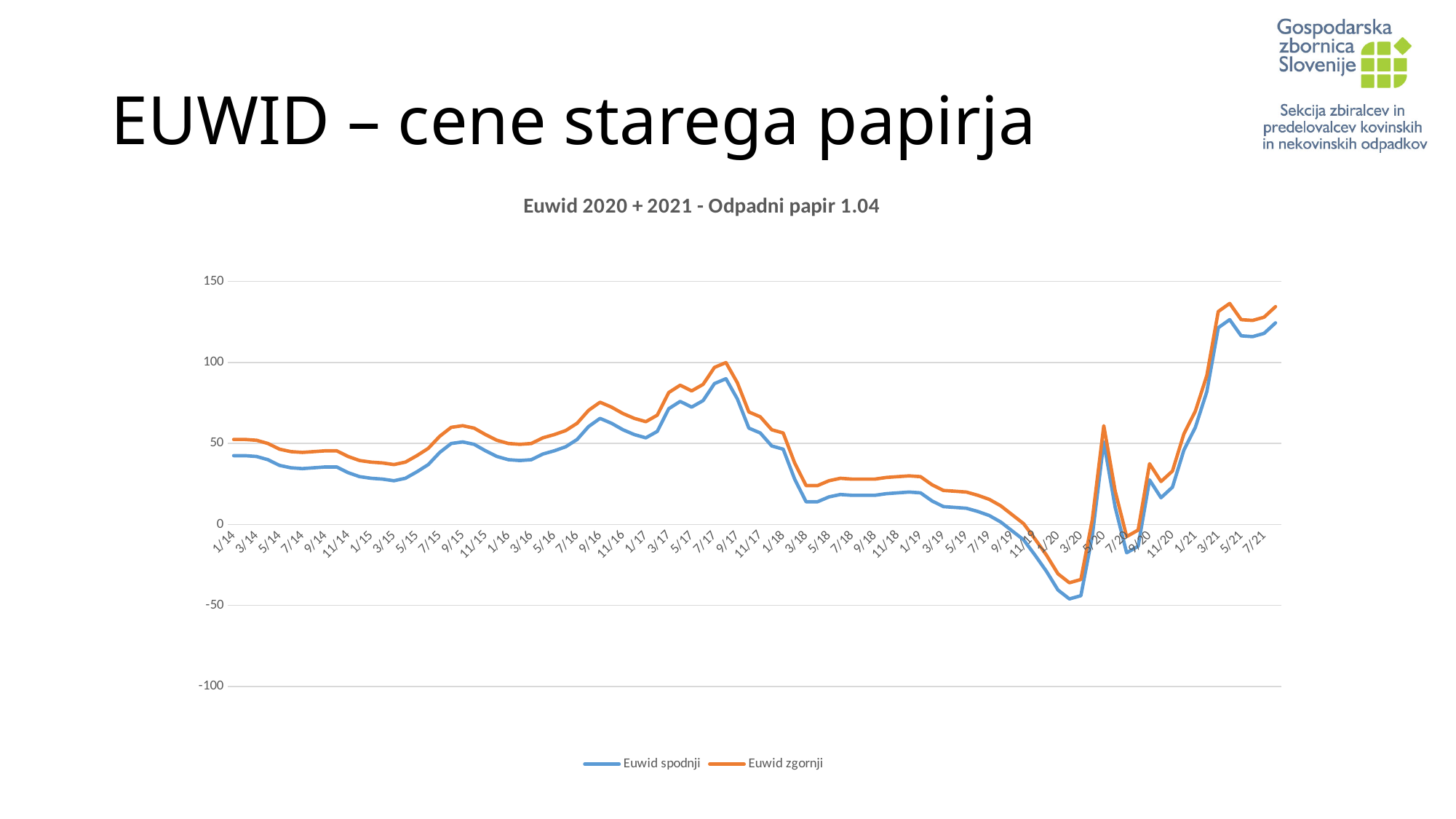
How many series does the chart legend list? 2 Do the values of Euwid spodnji rise or fall between 11/20 and 3/21? rise Is the value of Euwid zgornji at 3/21 greater or less than 100? greater Do the values of Euwid zgornji rise or fall between 9/17 and 3/18? fall Is the value of Euwid spodnji at 1/14 greater or less than 50? less Is the value of Euwid spodnji at 3/20 greater or less than 0? less What is the title of the chart? Euwid 2020 + 2021 - Odpadni papir 1.04 What kind of chart is shown on the slide? line chart At 9/17, which series has the higher value, Euwid spodnji or Euwid zgornji? Euwid zgornji Which series is drawn in orange? Euwid zgornji